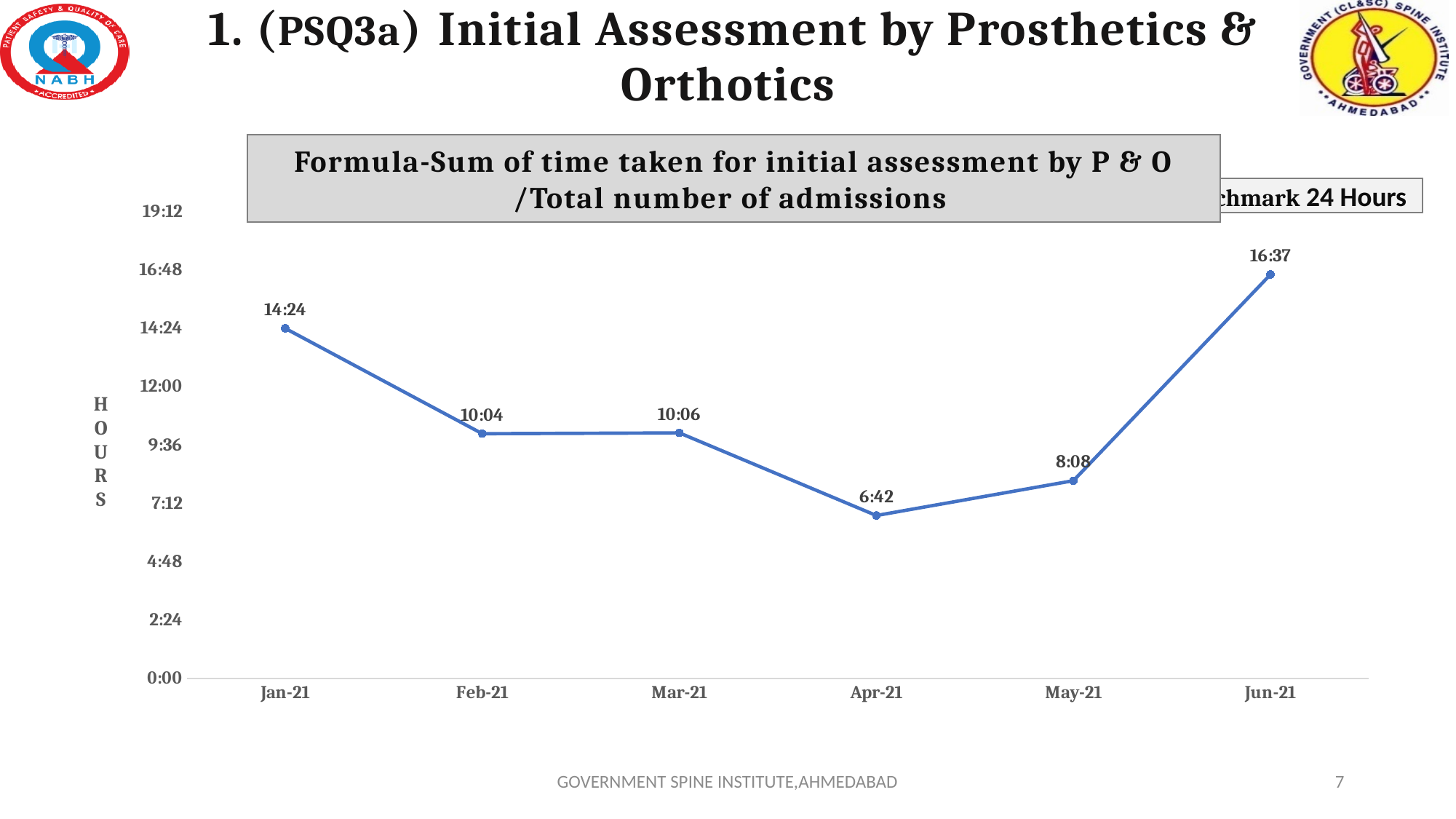
Which is larger, the value for Jan-21 or the value for May-21? Jan-21 What is the value for Jun-21? 16:37 What is the value for May-21? 8:08 Which month has the highest value? Jun-21 What is the value for Apr-21? 6:42 What is the difference between the values for Jun-21 and Jan-21? 2:13 How many months are plotted on the x axis? 6 Which month has the lowest value? Apr-21 What kind of chart is shown on the slide? Line chart What is the value for Jan-21? 14:24 What is the difference between the values for May-21 and Apr-21? 1:26 What is the label on the vertical axis of the chart? HOURS